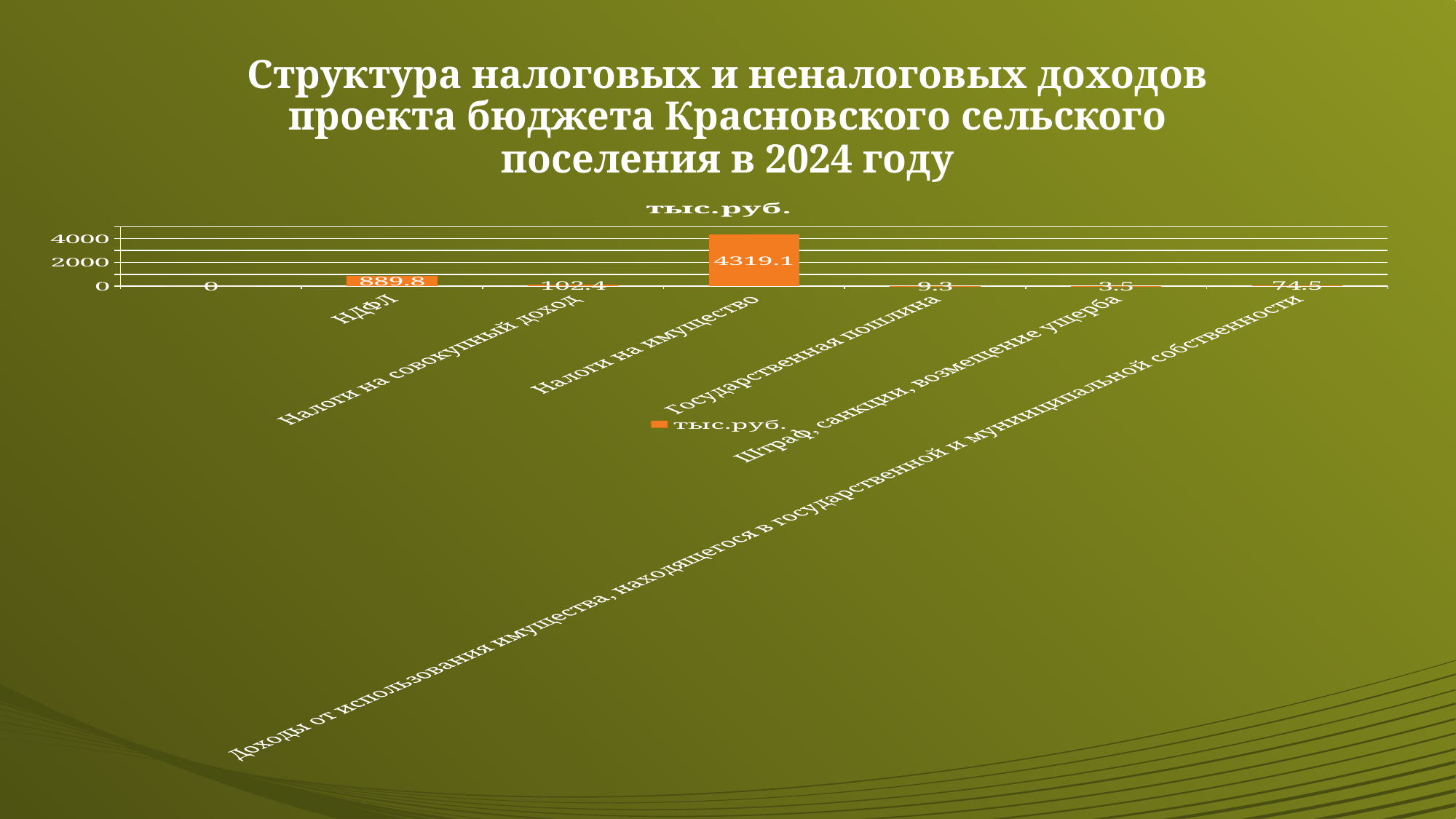
How many series does the legend list? 1 What is the value for Государственная пошлина? 9.3 What is the value for НДФЛ? 889.8 What is the value for Доходы от использования имущества, находящегося в государственной и муниципальной собственности? 74.5 Is the value for Налоги на имущество greater or less than 4000? greater What is the value for Штраф, санкции, возмещение ущерба? 3.5 What is the value for Налоги на имущество? 4319.1 What is the value for Налоги на совокупный доход? 102.4 What is the difference between the values for Налоги на имущество and НДФЛ? 3429.3 What kind of chart is shown on the slide? bar chart Which is larger, the value for НДФЛ or the value for Налоги на совокупный доход? НДФЛ Which category has the highest value? Налоги на имущество